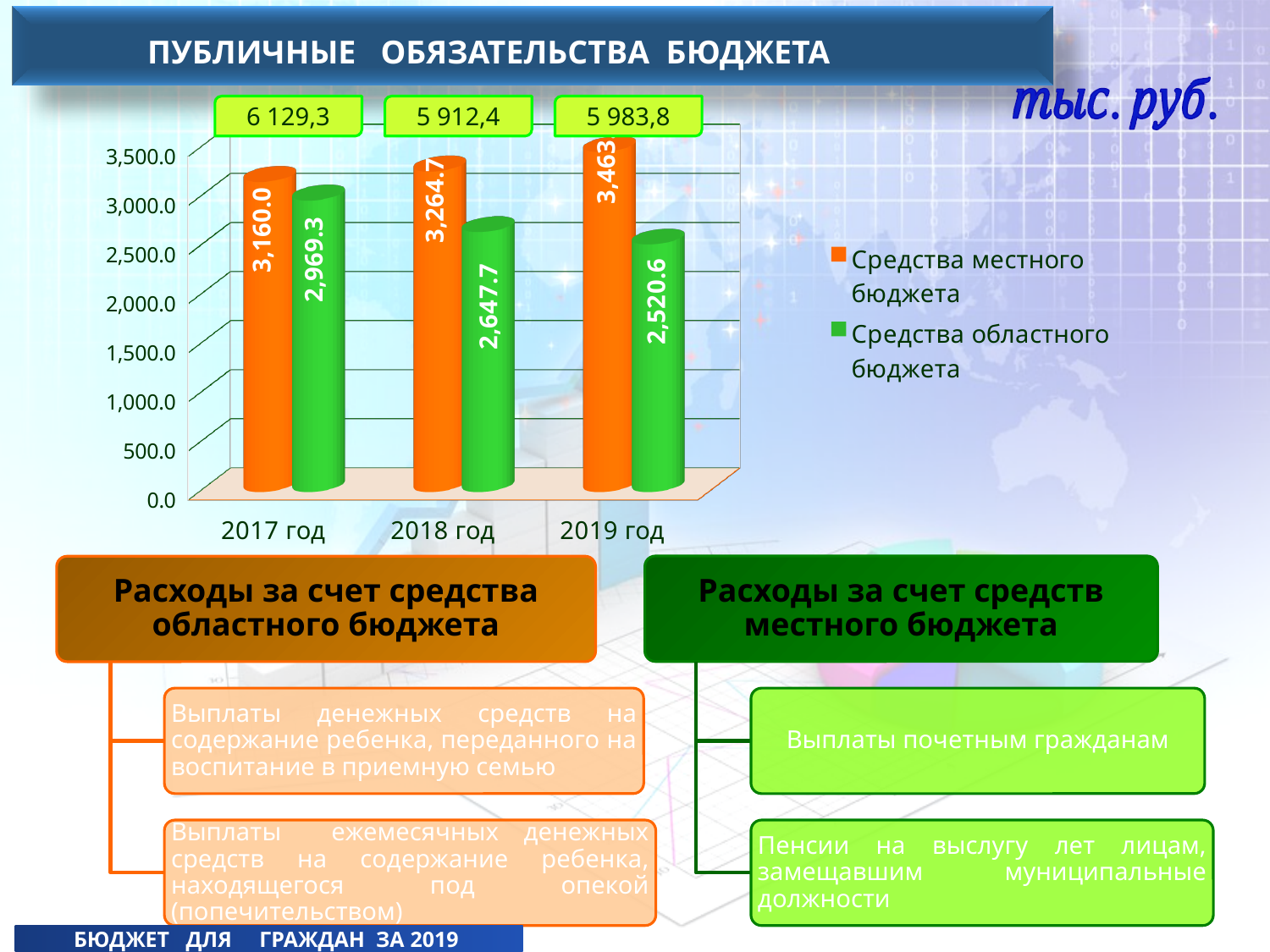
Does Средства областного бюджета rise or fall from 2017 год to 2019 год? fall In 2018 год, which is larger: Средства местного бюджета or Средства областного бюджета? Средства местного бюджета In which year is Средства областного бюджета the highest? 2017 год What is the value for Средства областного бюджета in 2018 год? 2,647.7 How many series does the legend list? 2 Is the value for Средства местного бюджета in 2019 год greater or less than 3,000.0? greater What is the value for Средства областного бюджета in 2019 год? 2,520.6 What is the value for Средства местного бюджета in 2017 год? 3,160.0 What is the total of the two series for 2018 год, as printed above the bars? 5 912,4 What is the value for Средства местного бюджета in 2018 год? 3,264.7 What is the difference between Средства местного бюджета and Средства областного бюджета in 2017 год? 190.7 In which year is Средства областного бюджета the lowest? 2019 год